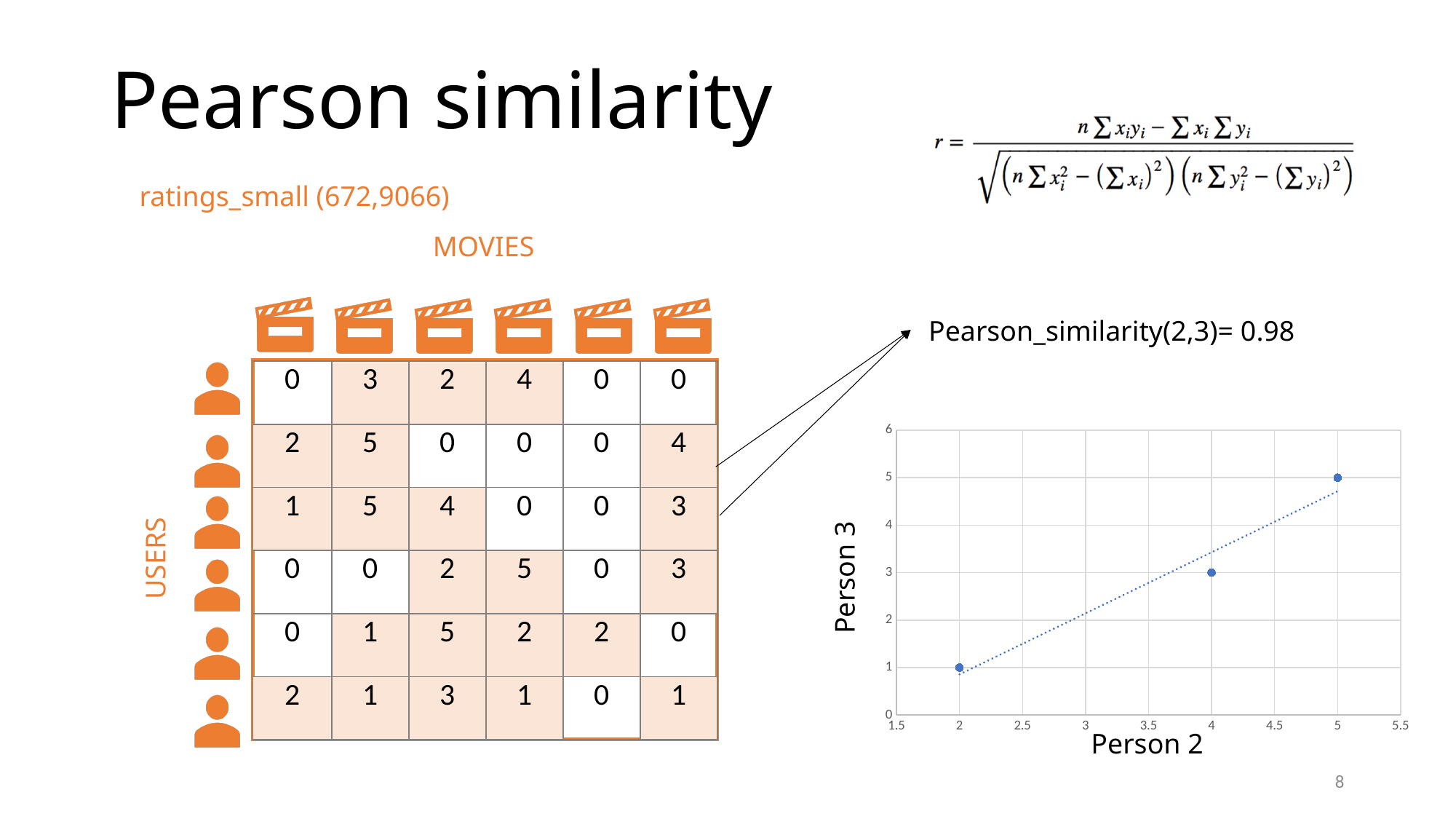
In the scatter chart, what is the Person 3 value of the point where Person 2 equals 5? 5 What kind of chart is shown on the slide? scatter plot What is the label of the x axis of the scatter chart? Person 2 Which point in the scatter chart has the highest Person 3 value? the point at Person 2 = 5 How many data points are plotted in the scatter chart? 3 What is the label of the y axis of the scatter chart? Person 3 What is the difference in Person 3 value between the point at Person 2 = 5 and the point at Person 2 = 2? 4 In the scatter chart, what is the Person 3 value of the point where Person 2 equals 2? 1 Do the Person 3 values rise or fall as Person 2 increases along the x axis? rise Is the Person 3 value of the point at Person 2 = 4 greater or less than 2? greater Which point in the scatter chart has the lowest Person 3 value? the point at Person 2 = 2 In the scatter chart, what is the Person 3 value of the point where Person 2 equals 4? 3